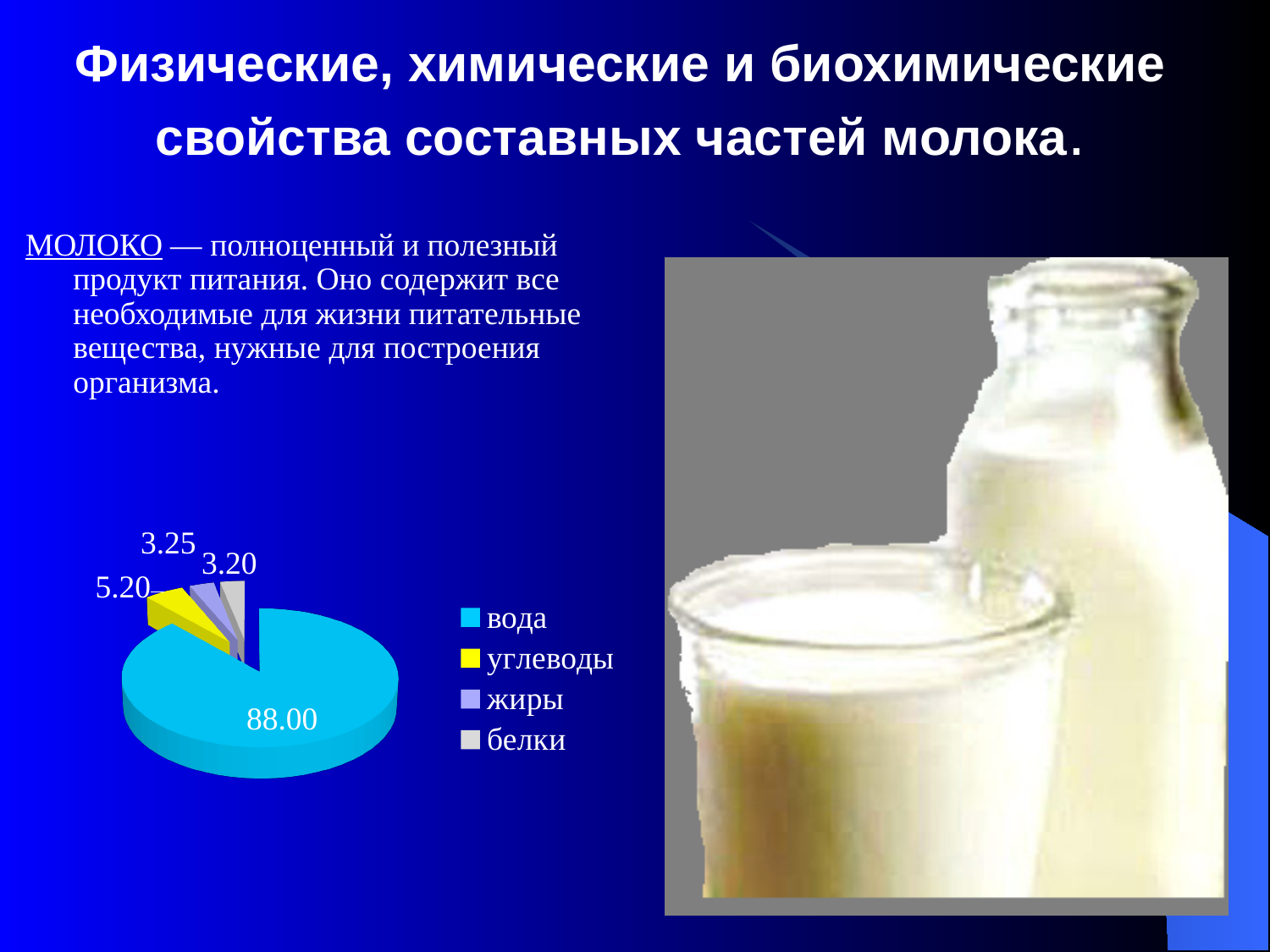
What is the value for вода in the pie chart? 88.00 What is the value for жиры in the pie chart? 3.25 What is the value for белки in the pie chart? 3.20 What kind of chart is shown on the slide? pie chart What is the difference between the values for вода and углеводы? 82.80 Which colour represents вода in the pie chart? blue How many slices does the pie chart have? 4 Which category has the smallest value in the pie chart? белки Which is larger, the value for углеводы or the value for жиры? углеводы Which category has the largest slice in the pie chart? вода What is the value for углеводы in the pie chart? 5.20 What is the difference between the values for жиры and белки? 0.05